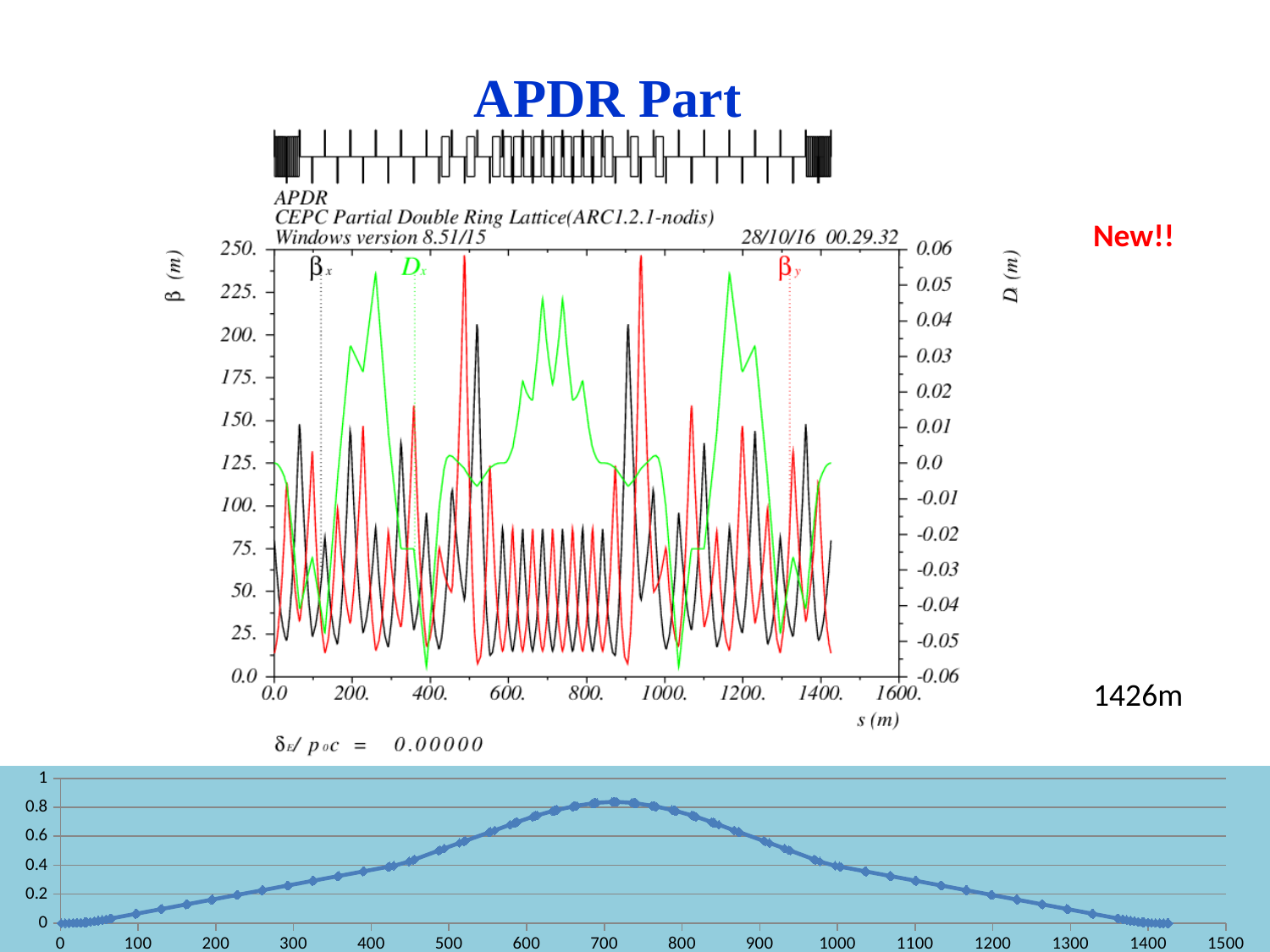
In the bottom chart, is the value at x = 800 greater or less than 0.6? greater What kind of chart is the bottom chart on the slide? line chart In the bottom chart, is the value at x = 200 greater or less than 0.2? less In the bottom chart, do the values rise or fall between x = 800 and x = 1400? fall In the top chart, is the minimum of the green Dx curve near s = 1040 greater or less than -0.04 m? less In the bottom chart, which is larger: the value at x = 700 or the value at x = 1100? x = 700 In the bottom chart, do the values rise or fall between x = 0 and x = 700? rise What is the highest tick value shown on the y axis of the bottom chart? 1 What is the title printed on the top chart (the lattice plot)? CEPC Partial Double Ring Lattice(ARC1.2.1-nodis) How many curves (series) are labelled in the top chart? 3